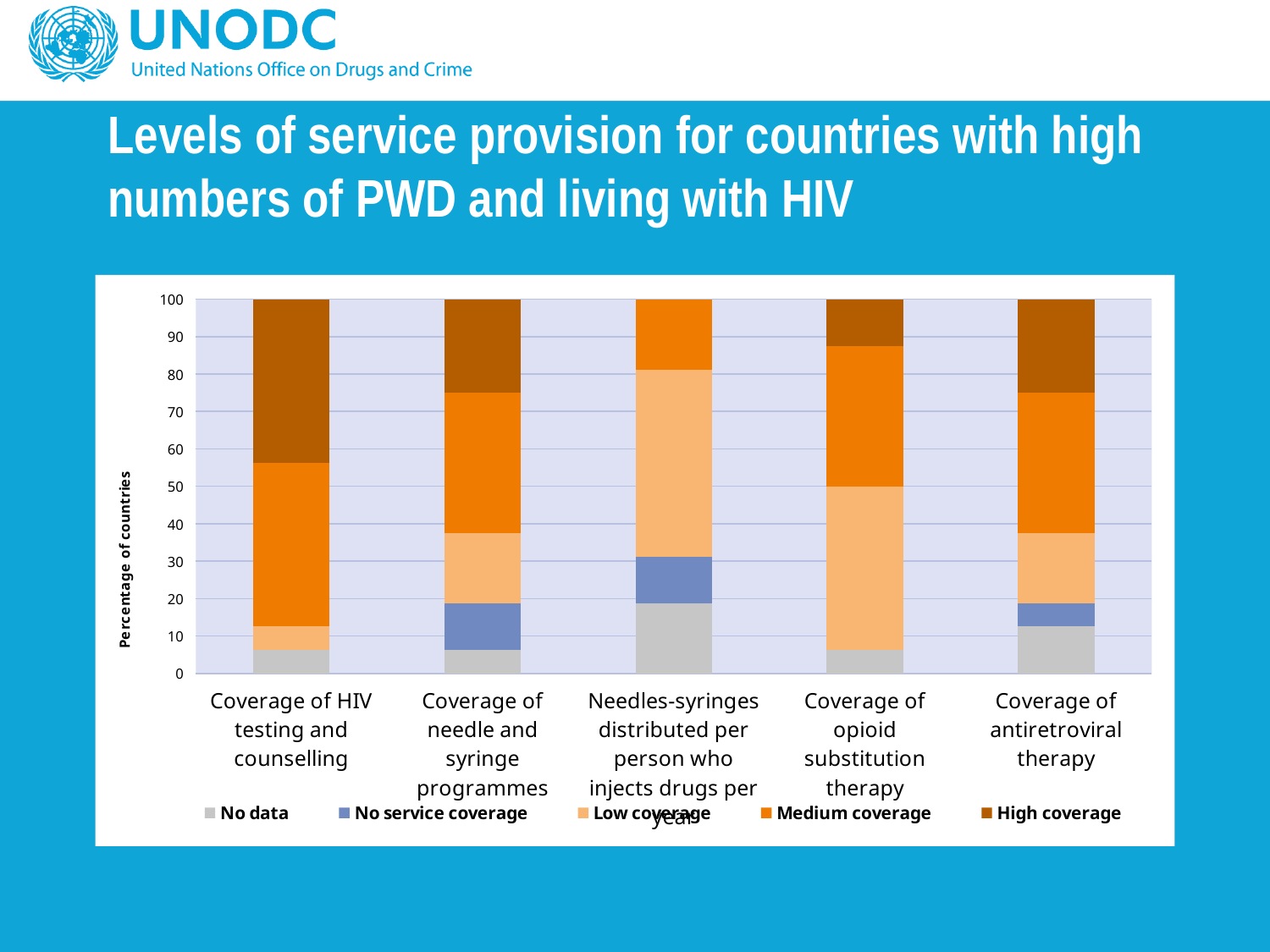
Is the Low coverage segment larger for Needles-syringes distributed per person who injects drugs per year or for Coverage of HIV testing and counselling? Needles-syringes distributed per person who injects drugs per year How many categories are shown along the x axis? 5 How many series does the legend list? 5 What is the label of the vertical axis? Percentage of countries Is the High coverage value for Coverage of HIV testing and counselling greater or less than 30? greater What is the total of the stacked bar for Coverage of opioid substitution therapy? 100 Which category has the largest High coverage segment? Coverage of HIV testing and counselling Is the No data value for Coverage of HIV testing and counselling greater or less than 10? less Which category has the largest Low coverage segment? Needles-syringes distributed per person who injects drugs per year Which category has the smallest High coverage segment? Needles-syringes distributed per person who injects drugs per year What kind of chart is shown on the slide? Stacked bar chart